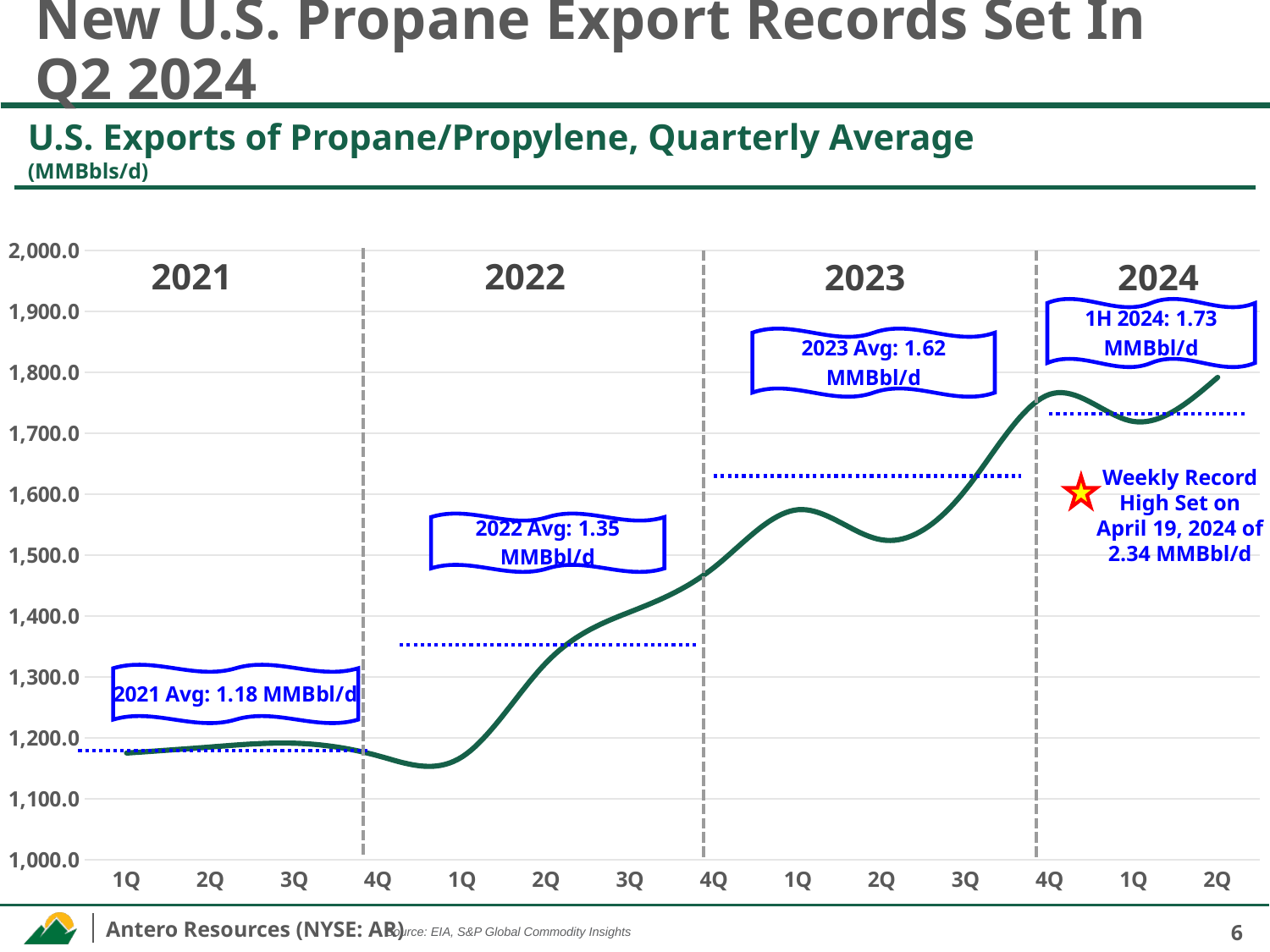
Is the value for 1Q 2021 greater or less than 1,200.0? less Which is larger, the value for 2Q 2024 or the value for 2Q 2023? 2Q 2024 What weekly record high was set on April 19, 2024 according to the chart annotation? 2.34 MMBbl/d What is the 1H 2024 average shown in the annotation on the chart? 1.73 MMBbl/d What is the difference between the 2023 average and the 2022 average shown in the annotations? 0.27 MMBbl/d What is the 2023 average shown in the annotation on the chart? 1.62 MMBbl/d What is the 2021 average shown in the annotation on the chart? 1.18 MMBbl/d What kind of chart is shown on the slide? line chart Is the value for 2Q 2024 greater or less than 1,700.0? greater How many quarterly points are plotted on the x axis? 14 What is the 2022 average shown in the annotation on the chart? 1.35 MMBbl/d Which quarter has the highest plotted value on the chart? 2Q 2024